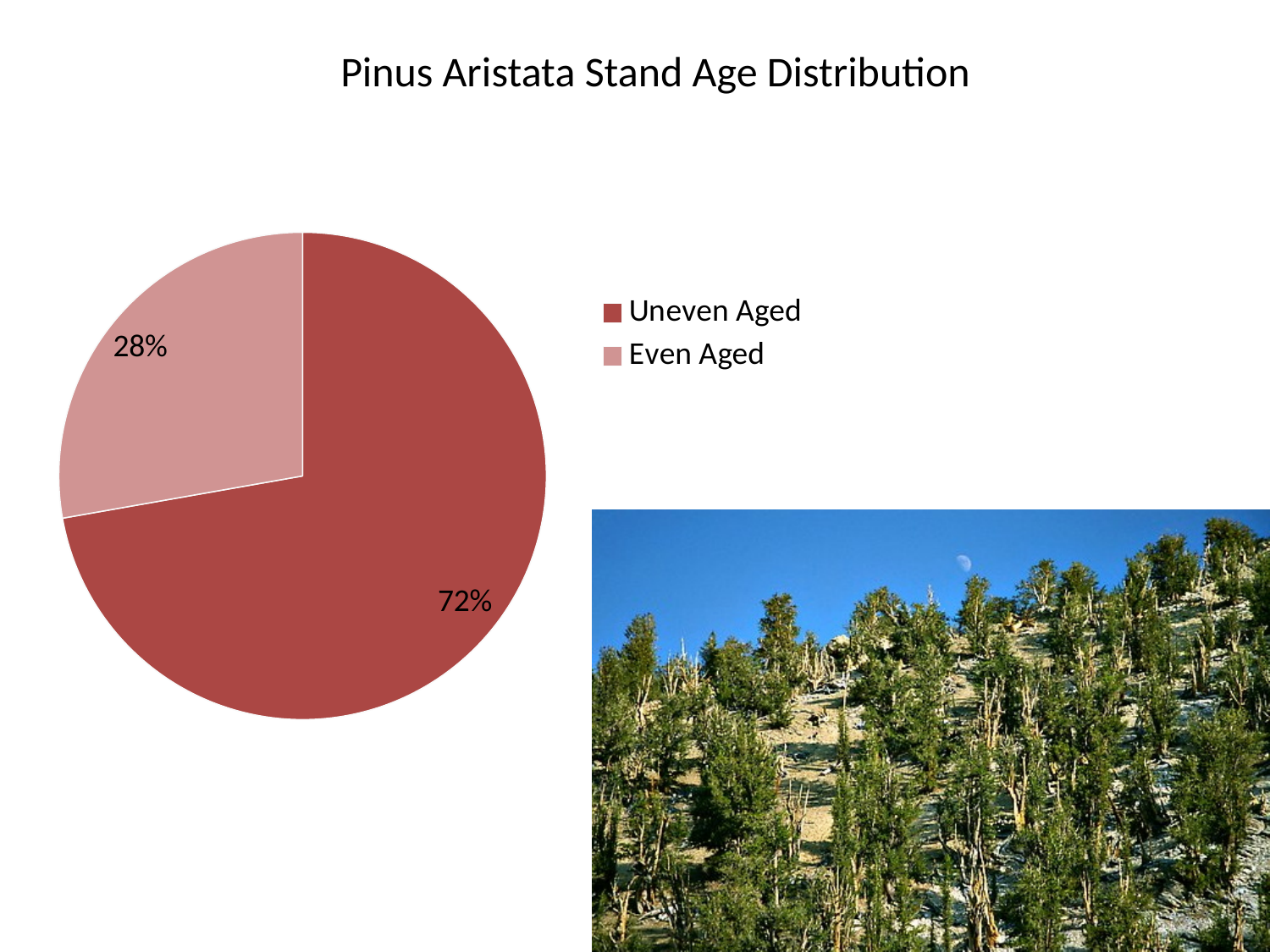
How many categories does the pie chart show? 2 What share of the pie is Uneven Aged? 72% What is the difference in percentage points between the Uneven Aged and Even Aged slices? 44 Which legend entry is shown in the darker red colour? Uneven Aged Which category has the smallest slice of the pie? Even Aged What share of the pie is Even Aged? 28% What kind of chart is shown on the slide? pie chart Which category has the largest slice of the pie? Uneven Aged How many entries does the legend list? 2 Which is larger, the Uneven Aged slice or the Even Aged slice? Uneven Aged What is the title of the chart? Pinus Aristata Stand Age Distribution